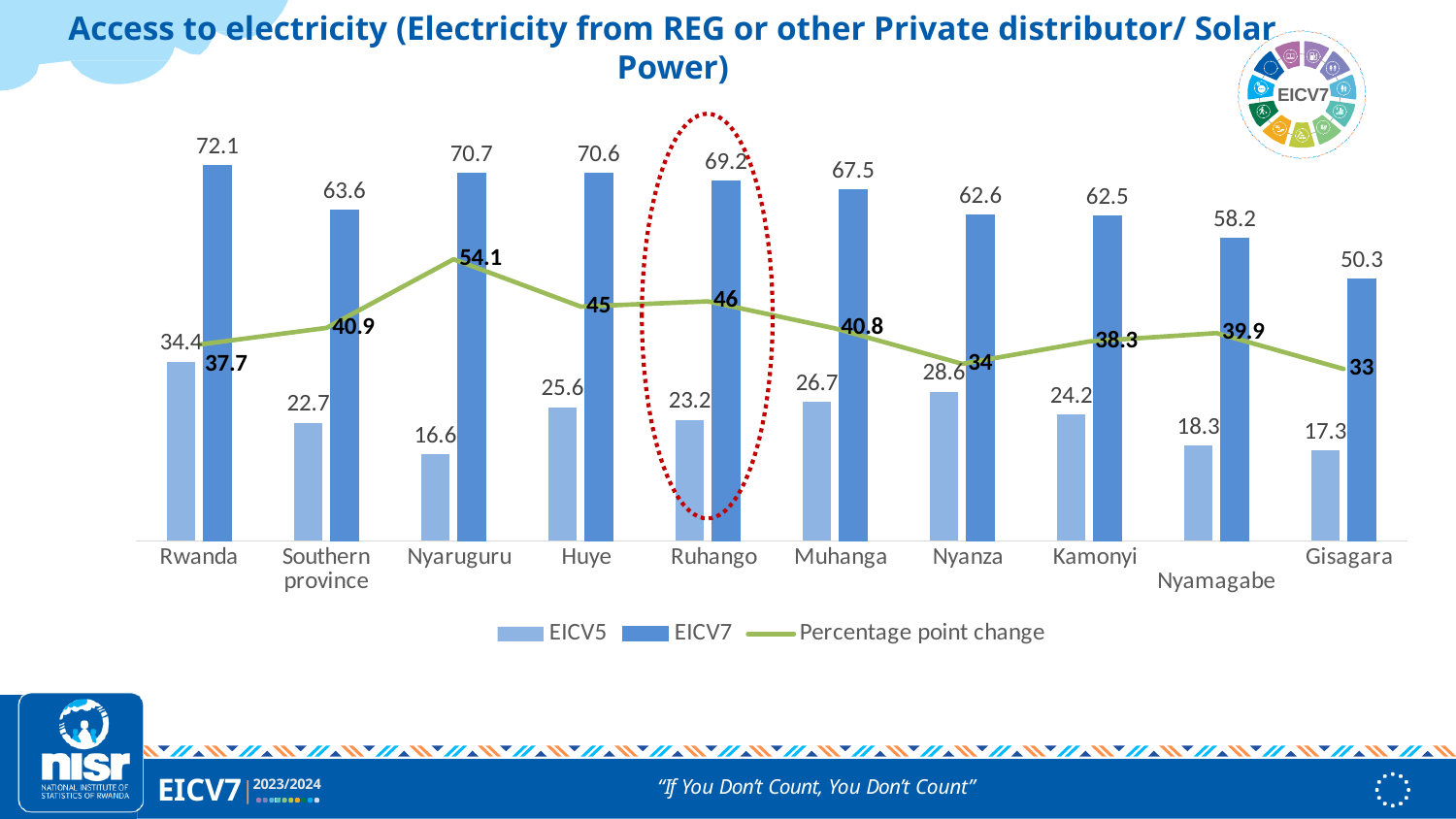
What is the EICV5 value for Ruhango? 23.2 Which category has the lowest EICV5 value? Nyaruguru How many series does the legend list? 3 Which category has the highest EICV7 value? Rwanda Which category is highlighted with a red dotted oval? Ruhango What is the difference between the EICV7 and EICV5 values for Gisagara? 33 Which is larger, the EICV7 value for Huye or the EICV7 value for Muhanga? Huye What is the percentage point change shown for Nyamagabe? 39.9 What kind of chart is this? bar chart with a line How many categories are shown on the x axis? 10 Which category has the highest percentage point change? Nyaruguru What is the EICV7 value for Nyaruguru? 70.7